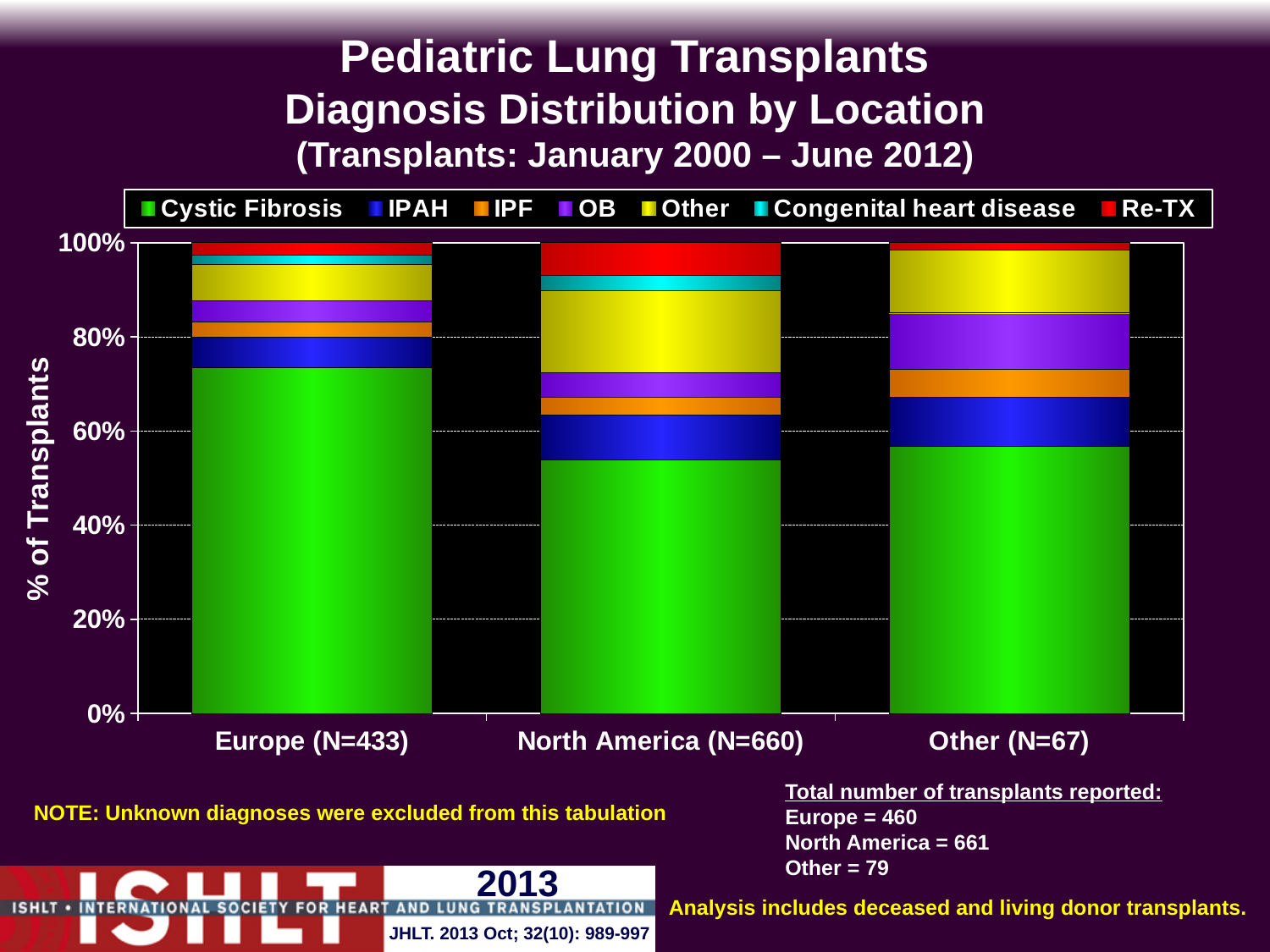
Which location has the largest OB share? Other (N=67) What is the N shown for North America on the x axis? 660 Is the Cystic Fibrosis share larger for Europe (N=433) or North America (N=660)? Europe (N=433) Is the Cystic Fibrosis share for North America (N=660) greater or less than 60%? less What is the label of the y axis? % of Transplants Is the Cystic Fibrosis share for Europe (N=433) greater or less than 60%? greater What does each stacked bar total? 100% How many diagnosis series does the legend list? 7 What kind of chart is shown on the slide? stacked bar chart Which location has the largest Cystic Fibrosis share? Europe (N=433) Is the 'Other' diagnosis share larger for Europe (N=433) or North America (N=660)? North America (N=660) How many location categories are shown on the x axis? 3